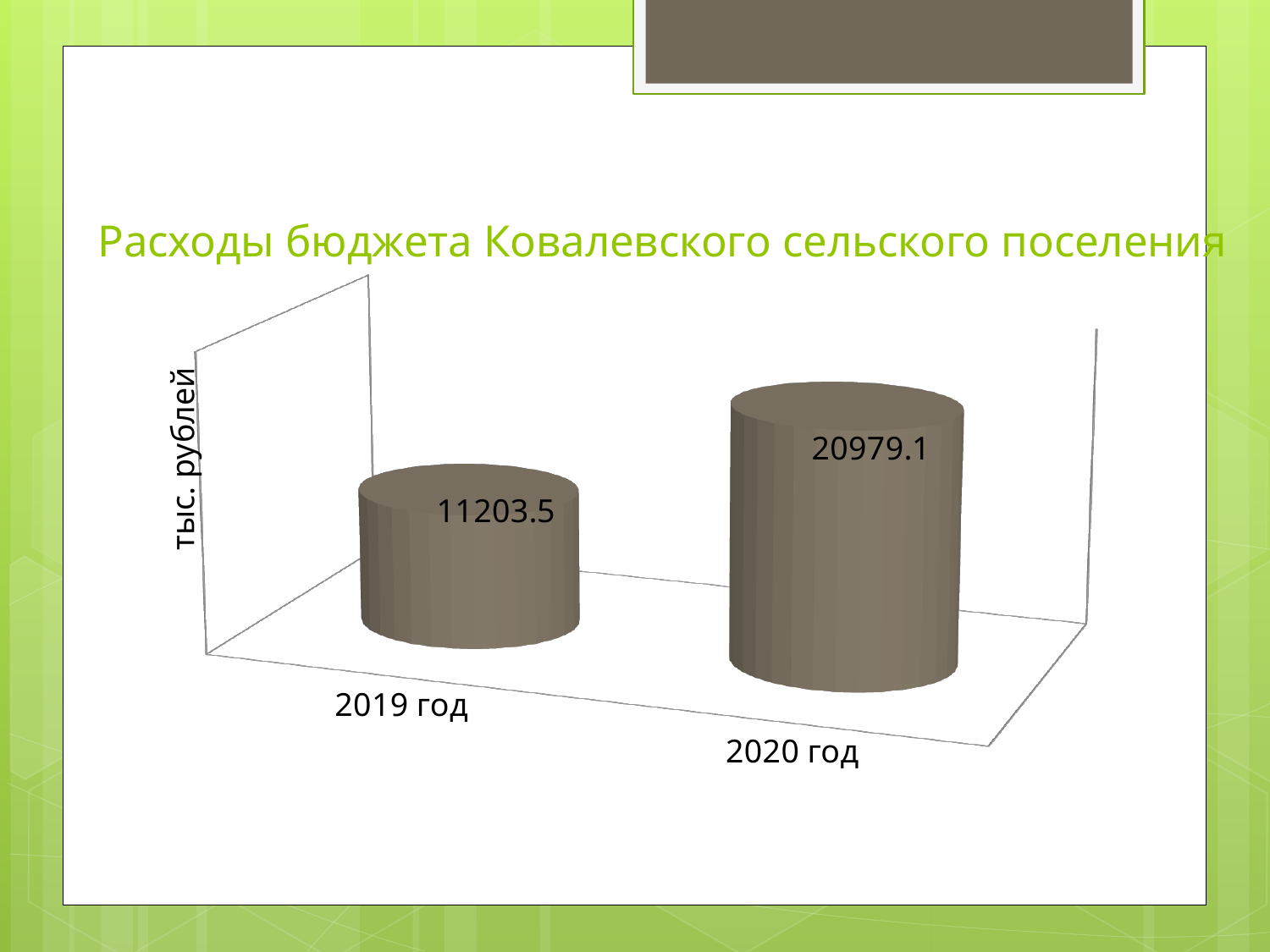
Which year has the lowest value? 2019 год What is the value for 2020 год? 20979.1 Do the values rise or fall from 2019 год to 2020 год? rise Which is larger, the value for 2019 год or the value for 2020 год? 2020 год What is the title of the chart? Расходы бюджета Ковалевского сельского поселения Which year has the highest value? 2020 год What is the value for 2019 год? 11203.5 What kind of chart is shown on the slide? bar chart What is the difference between the values for 2020 год and 2019 год? 9775.6 What is the label on the vertical axis? тыс. рублей How many categories are shown on the chart? 2